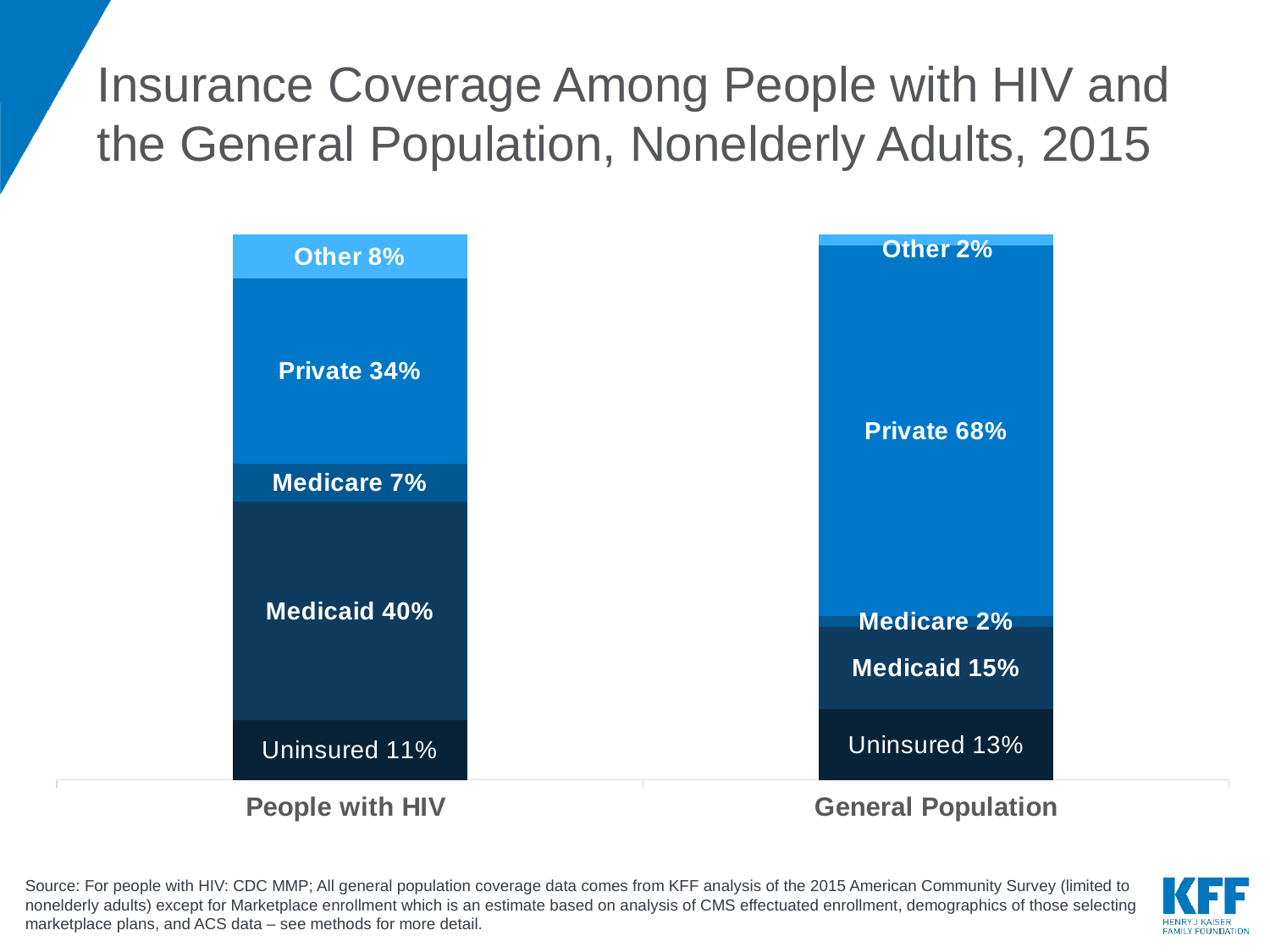
What is the total of the segments in the People with HIV bar? 100% How many coverage segments make up each bar? 5 Which coverage type is the smallest segment for the General Population? Other (2%) and Medicare (2%) What share of the General Population has Private coverage? 68% What share of People with HIV are covered by Medicaid? 40% What is the Medicare share for the General Population? 2% Which group has a larger Uninsured share, People with HIV or the General Population? General Population Which coverage type is the largest segment for People with HIV? Medicaid How much larger is the Private share for the General Population than for People with HIV? 34 percentage points How many groups (bars) are shown on the chart? 2 What kind of chart is shown on the slide? Stacked bar chart What is the Uninsured share for People with HIV? 11%